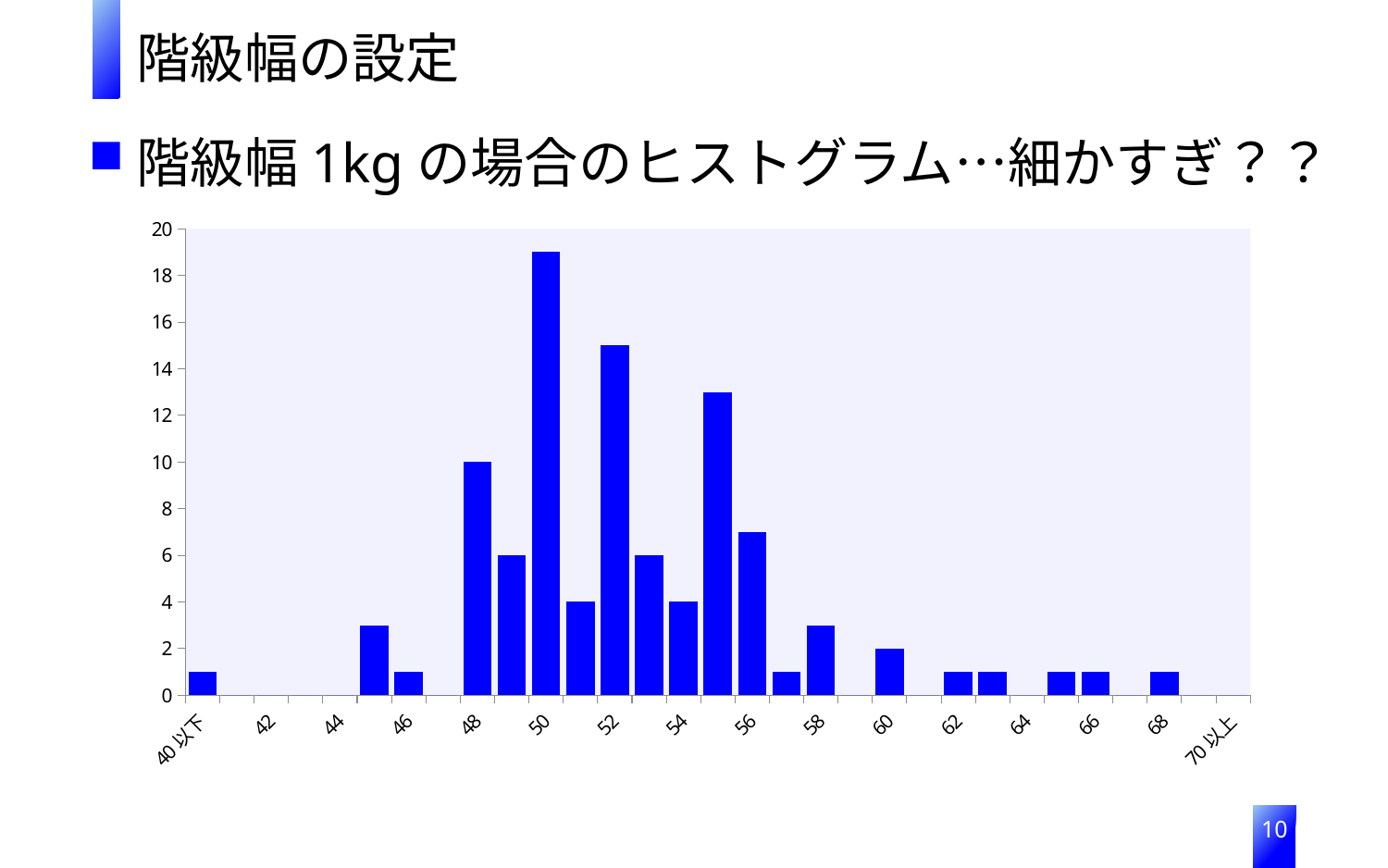
Is the value for category 46 greater or less than 2? less What is the difference between the values for categories 48 and 54? 6 What is the value for category 48? 10 What type of chart is shown on the slide? bar chart Is the value for category 52 greater or less than 14? greater How many labels are shown on the x axis? 16 Which category has the highest bar? 50 Is the value for category 50 greater or less than 18? greater What is the value for category 60? 2 What is the value for category 54? 4 What is the highest value shown on the y axis? 20 Which is larger, the value for category 48 or the value for category 52? 52